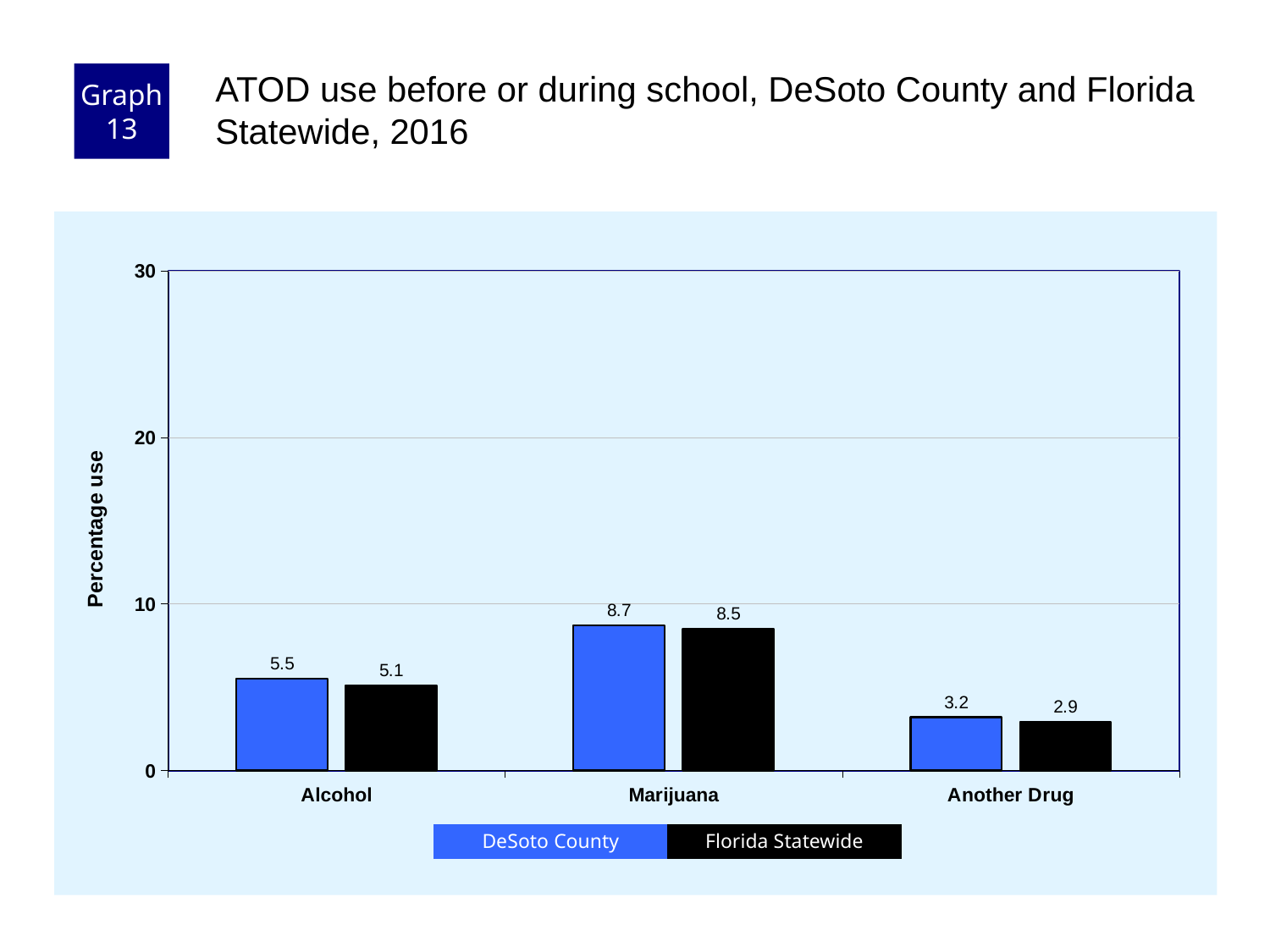
Is the Florida Statewide value for Marijuana greater or less than 10? less What is the difference between the DeSoto County values for Marijuana and Another Drug? 5.5 What is the difference between the DeSoto County and Florida Statewide values for Alcohol? 0.4 How many categories are shown on the x axis? 3 What is the DeSoto County value for Marijuana? 8.7 What kind of chart is shown on the slide? bar chart How many series does the legend list? 2 What is the Florida Statewide value for Alcohol? 5.1 Which category has the highest DeSoto County value? Marijuana Which category has the lowest Florida Statewide value? Another Drug Which is larger for Another Drug, the DeSoto County value or the Florida Statewide value? DeSoto County What is the DeSoto County value for Another Drug? 3.2